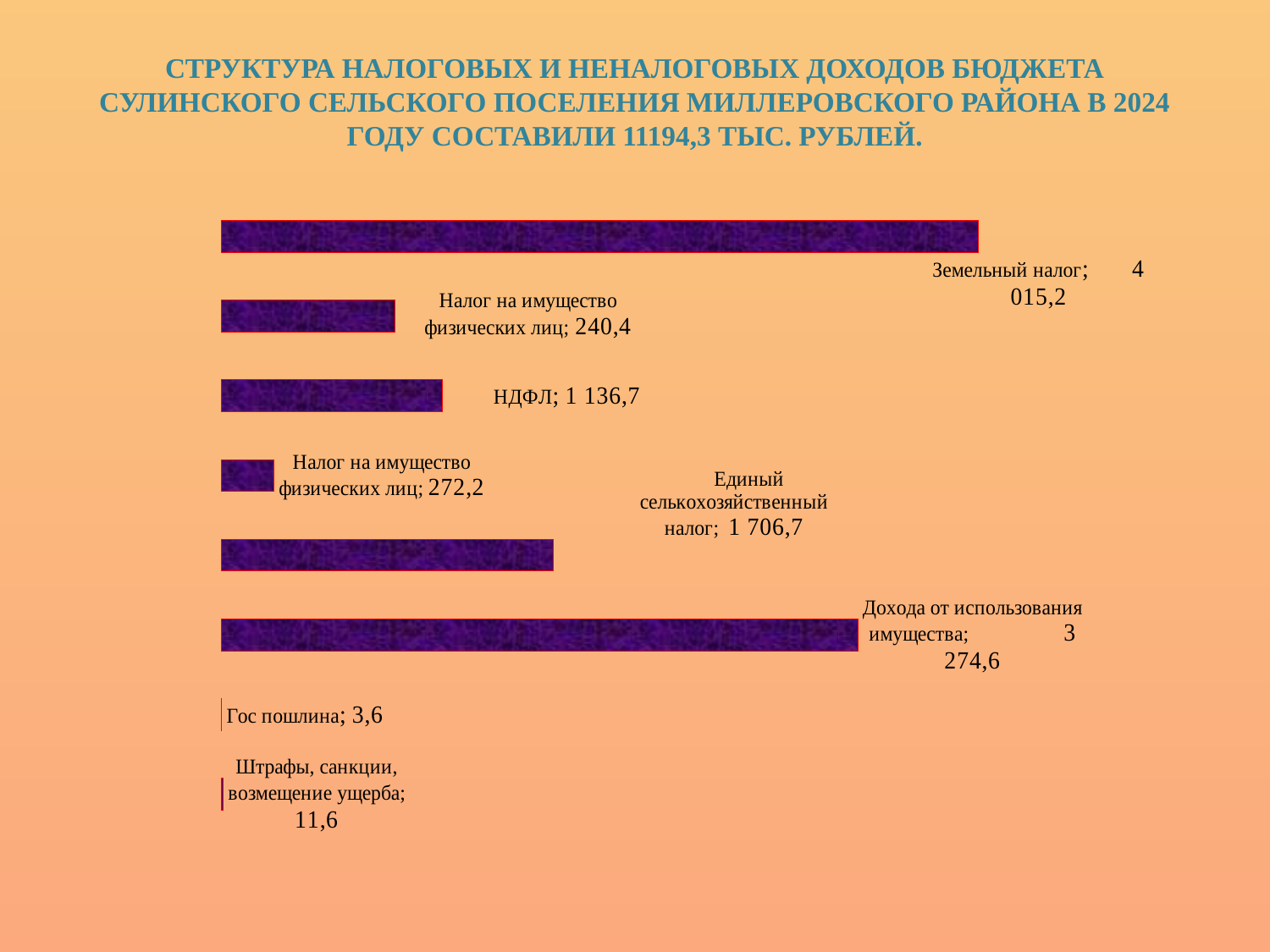
What is the value for Земельный налог? 4 015,2 What is the value for Штрафы, санкции, возмещение ущерба? 11,6 What is the difference between Земельный налог and Дохода от использования имущества? 740,6 Which is larger, НДФЛ or Единый сельскохозяйственный налог? Единый сельскохозяйственный налог Which category has the lowest value? Гос пошлина Which category has the highest value? Земельный налог What is the value for Единый сельскохозяйственный налог? 1 706,7 How many bars are shown in the chart? 8 What kind of chart is shown on the slide? bar chart What is the value for НДФЛ? 1 136,7 What is the value for Гос пошлина? 3,6 What is the value for Дохода от использования имущества? 3 274,6